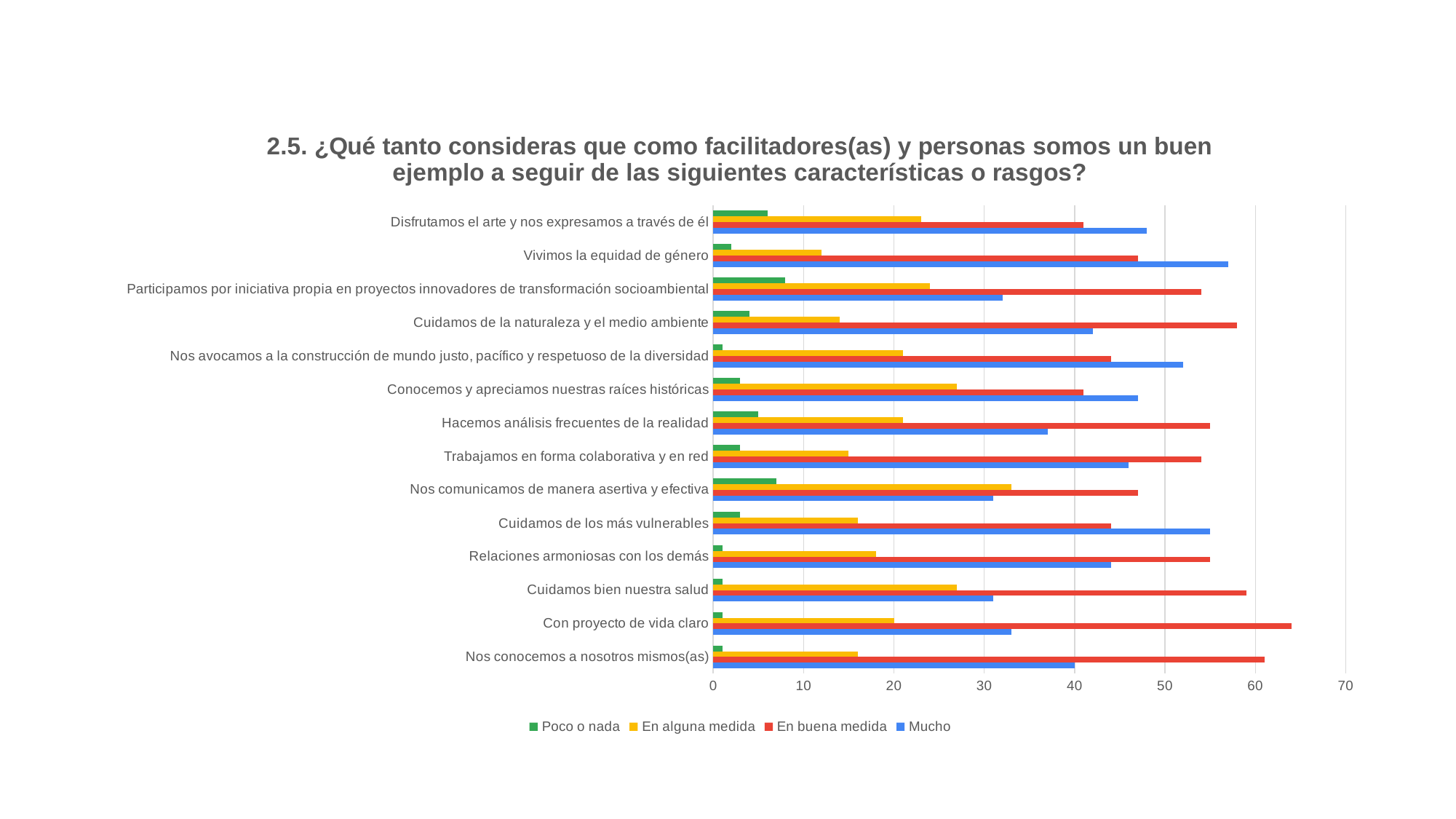
How many series does the legend list? 4 How many categories (characteristics) are plotted on the chart? 14 Is the 'Poco o nada' value for 'Disfrutamos el arte y nos expresamos a través de él' greater or less than 10? less Is the 'Mucho' value for 'Vivimos la equidad de género' greater or less than 50? greater Is the 'En buena medida' value for 'Con proyecto de vida claro' greater or less than 60? greater For 'Cuidamos bien nuestra salud', which is larger: 'Mucho' or 'En buena medida'? En buena medida What kind of chart is shown on the slide? bar chart Which category has the longest 'En alguna medida' bar? Nos comunicamos de manera asertiva y efectiva For 'Con proyecto de vida claro', which is larger: 'En buena medida' or 'Mucho'? En buena medida Which colour represents the 'Mucho' series in the legend? blue